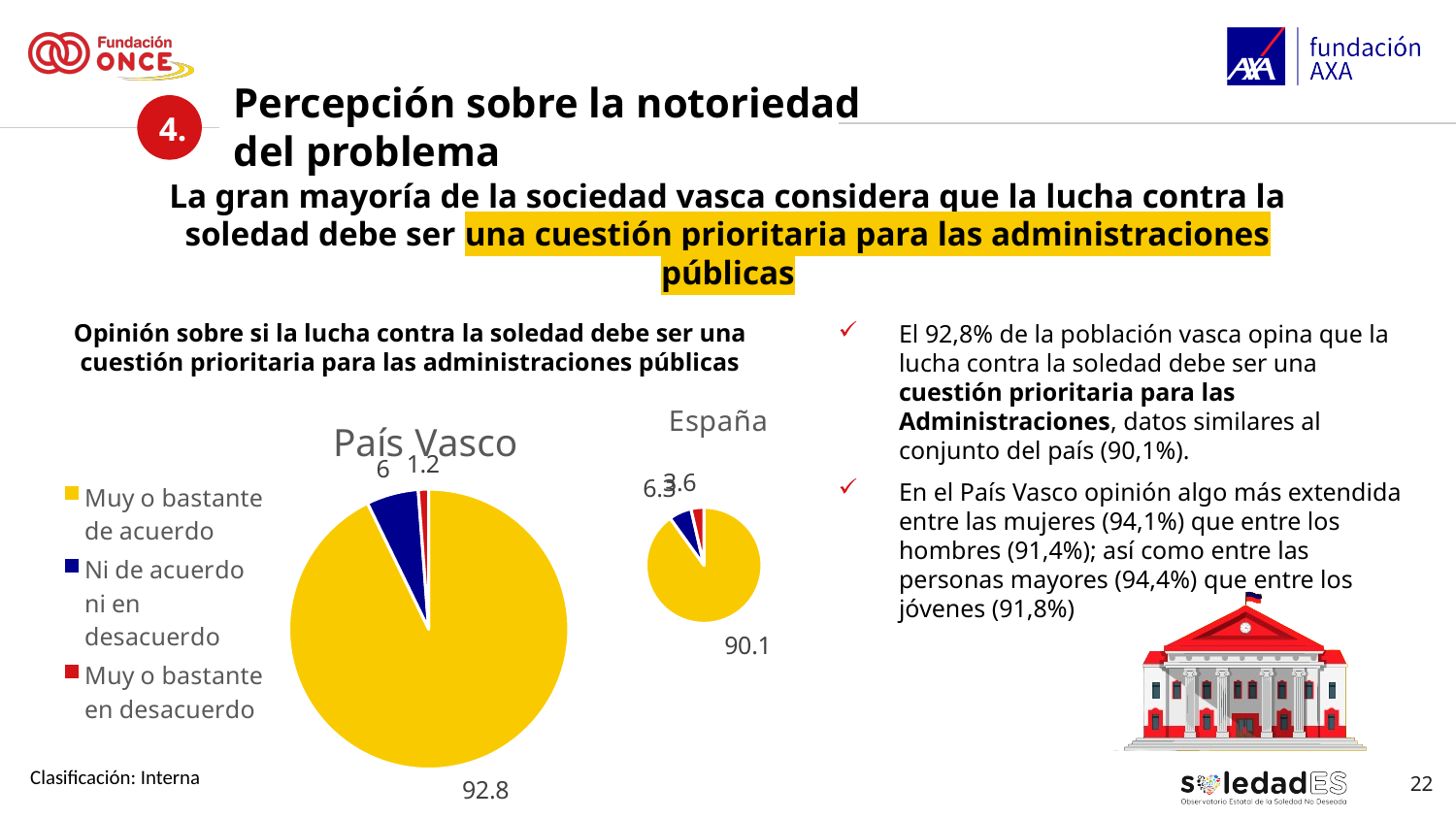
How many categories does the legend list for the pie charts? 3 Which is larger: the "Muy o bastante de acuerdo" value for País Vasco or for España? País Vasco What is the difference between the "Muy o bastante de acuerdo" value in the País Vasco chart and the same value in the España chart? 2.7 In the País Vasco pie chart, what is the difference between "Ni de acuerdo ni en desacuerdo" and "Muy o bastante en desacuerdo"? 4.8 In the País Vasco pie chart, which category has the smallest slice? Muy o bastante en desacuerdo Which colour represents "Muy o bastante de acuerdo" in the pie charts? Yellow What type of chart is used to show the País Vasco data? Pie chart In the País Vasco pie chart, what is the value for "Ni de acuerdo ni en desacuerdo"? 6 In the País Vasco pie chart, what is the value for "Muy o bastante de acuerdo"? 92.8 In the País Vasco pie chart, which category has the largest slice? Muy o bastante de acuerdo In the País Vasco pie chart, what is the value for "Muy o bastante en desacuerdo"? 1.2 In the España pie chart, what is the value for "Muy o bastante de acuerdo"? 90.1